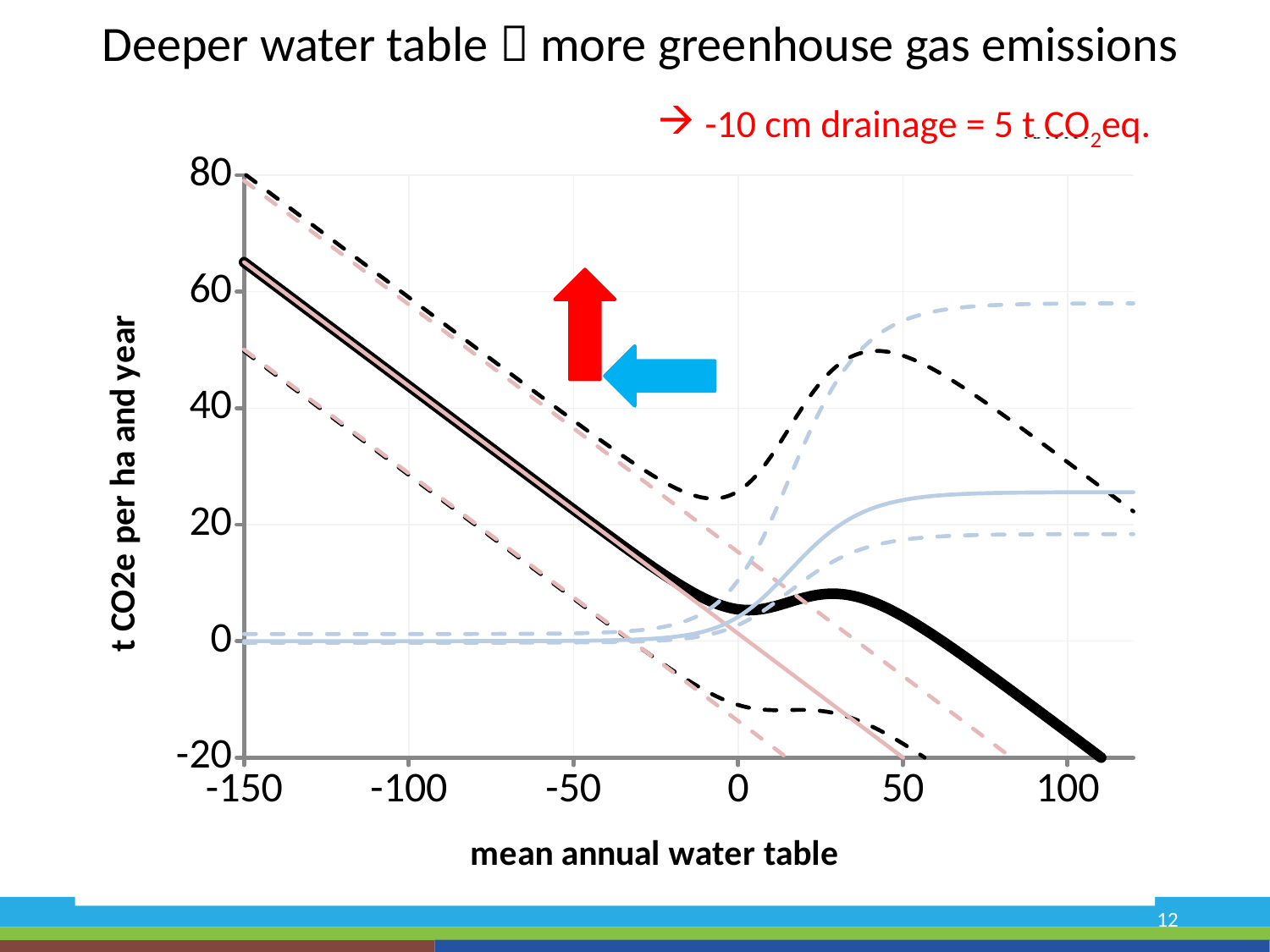
What is the label of the y axis of the chart? t CO2e per ha and year Is the value of the thick black line at a mean annual water table of 100 greater or less than 0? less Is the value of the upper dashed light blue line at a mean annual water table of 100 greater or less than 40? greater Is the value of the thick black line at a mean annual water table of -100 greater or less than 40? greater What kind of chart is shown on the slide? line chart Does the thick black line rise or fall as the mean annual water table increases from -150 to 0? fall What is the lowest value shown on the y axis of the chart? -20 What is the label of the x axis of the chart? mean annual water table Does the solid light blue line rise or fall as the mean annual water table increases from 0 to 50? rise